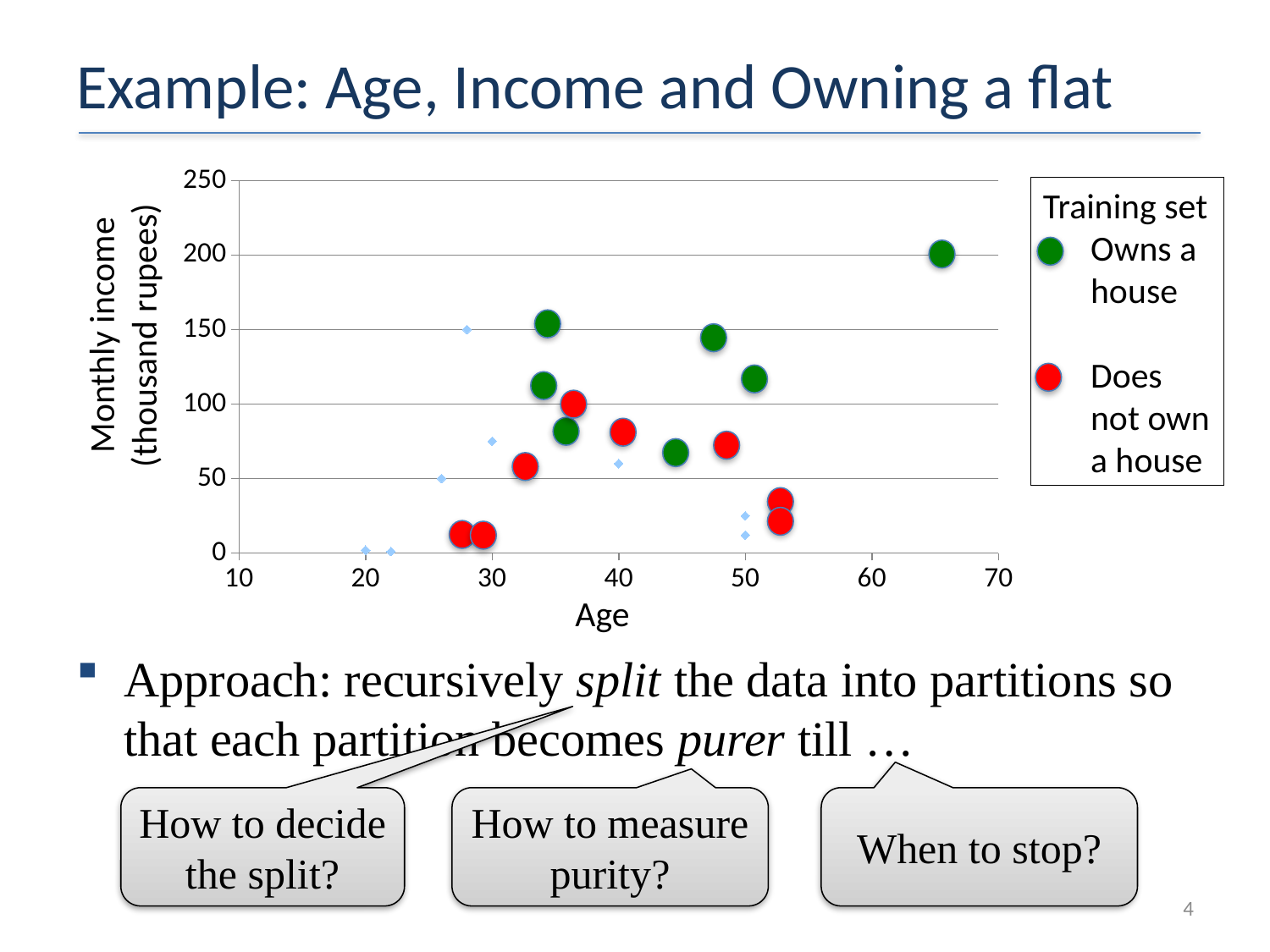
Is the age of the highest-income point greater or less than 60? greater Which group contains the point with the lowest monthly income, 'Owns a house' or 'Does not own a house'? Does not own a house Is the monthly income of the two red points near age 28-30 greater or less than 50? less What is the label of the x axis of the chart? Age Is the monthly income of the red point near age 53 greater or less than 50? less How many categories does the legend of the chart list under 'Training set'? 2 How many red 'Does not own a house' points are plotted on the chart? 8 Which group does the point with the highest monthly income belong to, 'Owns a house' or 'Does not own a house'? Owns a house What is the label of the y axis of the chart? Monthly income (thousand rupees) What kind of chart is shown on the slide? Scatter plot How many green 'Owns a house' points are plotted on the chart? 7